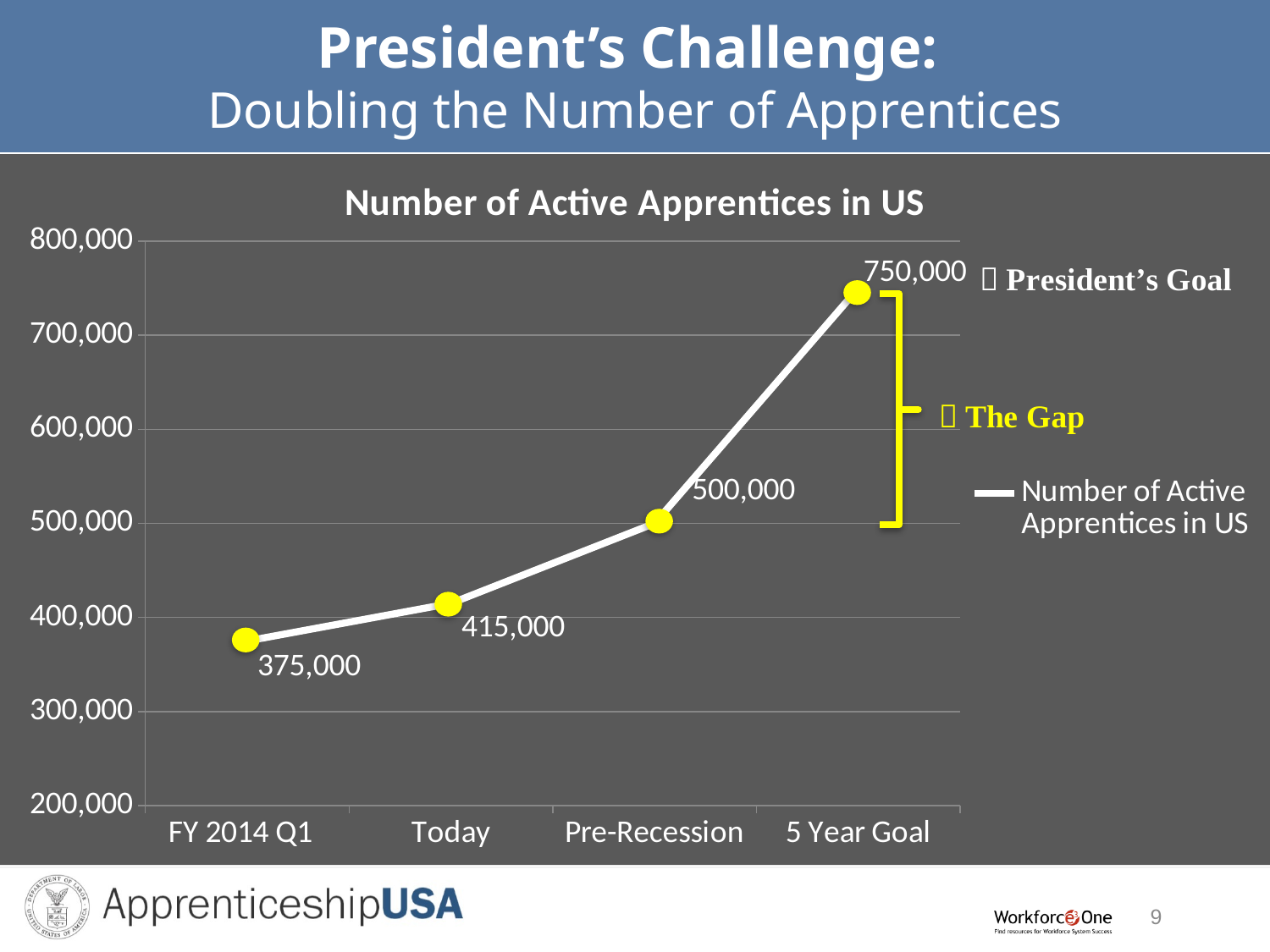
Which category has the highest number of active apprentices? 5 Year Goal Which category has the lowest number of active apprentices? FY 2014 Q1 What is the difference between the Pre-Recession value and the FY 2014 Q1 value? 125,000 What is the value shown for Today? 415,000 Which is larger, the value for Today or the value for Pre-Recession? Pre-Recession How many data points are plotted on the chart? 4 What is the difference between the 5 Year Goal and the Today value? 335,000 What is the value shown for Pre-Recession? 500,000 Do the values rise or fall from FY 2014 Q1 to 5 Year Goal? Rise What is the value shown for the 5 Year Goal? 750,000 What kind of chart is shown on the slide? Line chart What is the number of active apprentices for FY 2014 Q1? 375,000